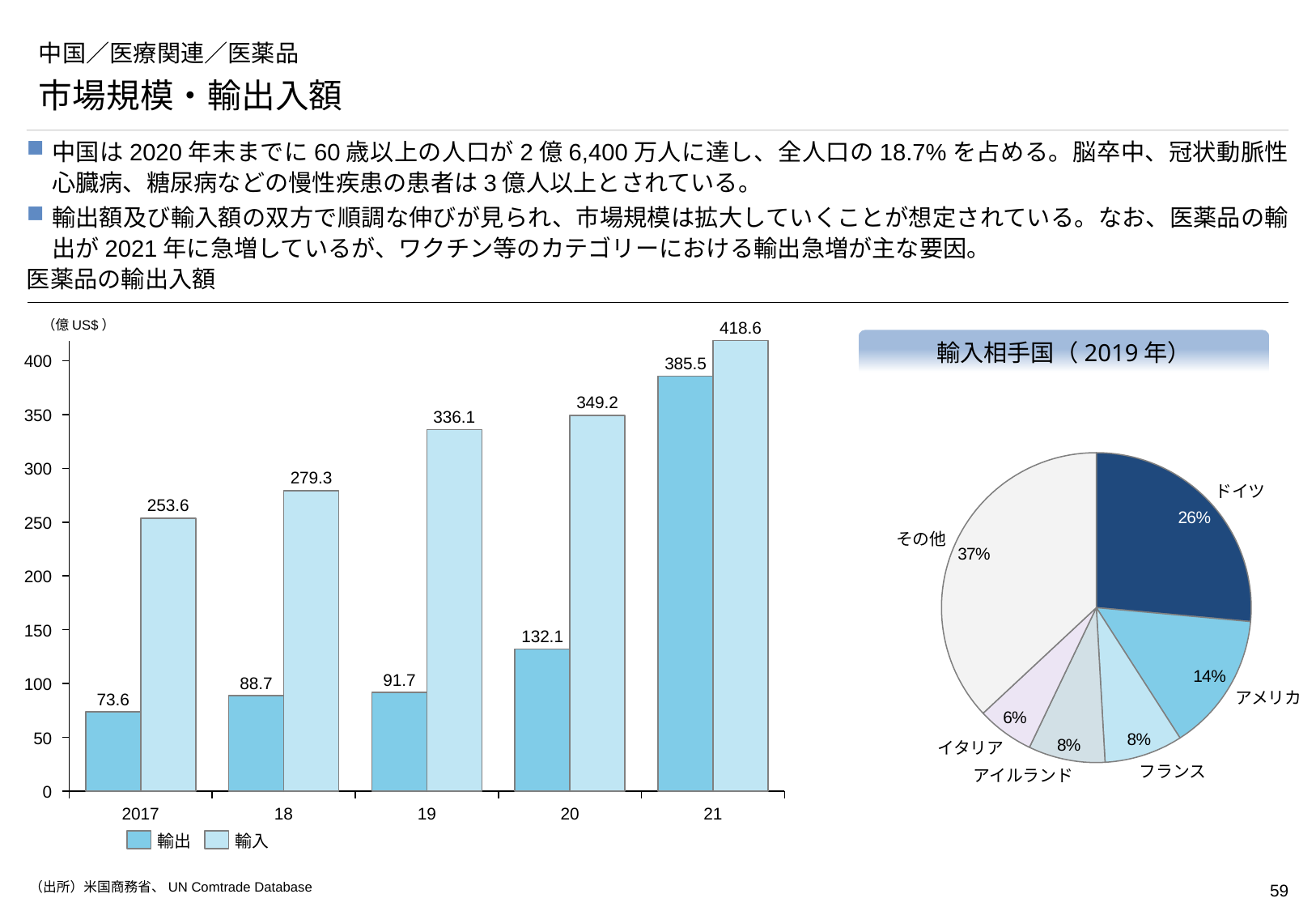
医薬品の輸出入額のグラフで、輸入額が最も高い年はどれですか？ 21 医薬品の輸出入額のグラフで、輸出額が最も低い年はどれですか？ 2017 医薬品の輸出入額のグラフは、どの種類のグラフですか？ 棒グラフ 医薬品の輸出入額のグラフで、輸入額は2017年から2021年にかけて増加していますか、減少していますか？ 増加 医薬品の輸出入額のグラフで、2021年の輸出額はいくらですか？ 385.5 輸入相手国（2019年）の円グラフで、最も割合が小さい国はどこですか？ イタリア 輸入相手国（2019年）の円グラフには、いくつの区分がありますか？ 6 輸入相手国（2019年）の円グラフで、ドイツの割合は何％ですか？ 26% 医薬品の輸出入額のグラフで、2018年の輸出額と2019年の輸出額ではどちらが大きいですか？ 2019年の輸出額 医薬品の輸出入額のグラフで、2020年の輸入額と輸出額の差はいくらですか？ 217.1 医薬品の輸出入額のグラフで、凡例にはいくつの系列がありますか？ 2 医薬品の輸出入額のグラフで、2019年の輸入額はいくらですか？ 336.1